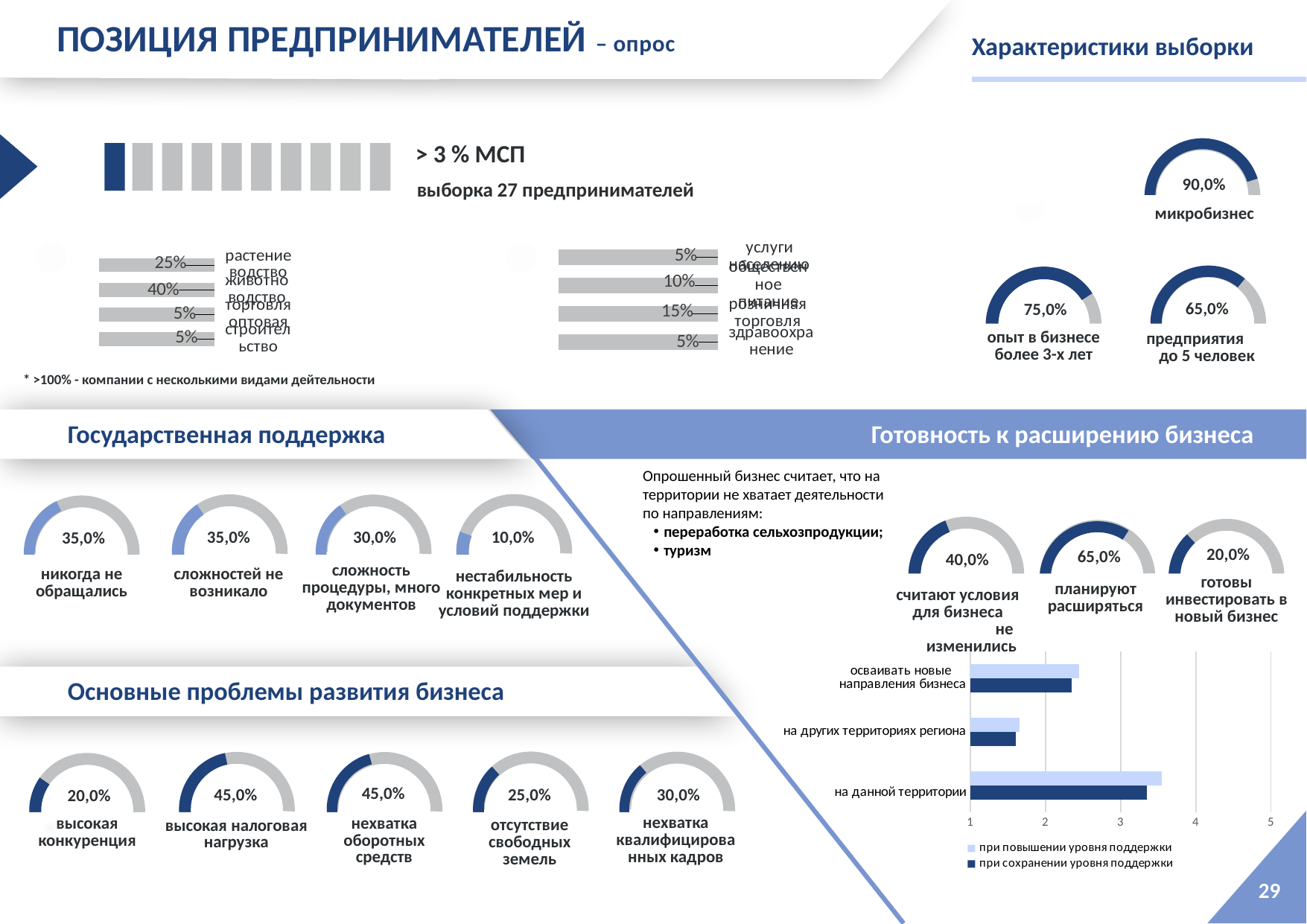
In the 'Государственная поддержка' section, what is the value shown for 'нестабильность конкретных мер и условий поддержки'? 10,0% In the 'Характеристики выборки' section, which is larger: 'микробизнес' or 'предприятия до 5 человек'? микробизнес In the bar chart at the bottom right, is the value for 'на данной территории' in the series 'при повышении уровня поддержки' greater or less than 3? greater In the 'Основные проблемы развития бизнеса' section, which problem has the lowest value? высокая конкуренция In the bar chart at the bottom right, which category has the lowest values? на других территориях региона In the bar chart at the bottom right with the legend 'при повышении уровня поддержки' / 'при сохранении уровня поддержки', how many series does the legend list? 2 What kind of chart is the chart at the bottom right with categories 'на данной территории', 'на других территориях региона' and 'осваивать новые направления бизнеса'? bar chart In the 'Готовность к расширению бизнеса' section, what is the difference between 'планируют расширяться' and 'готовы инвестировать в новый бизнес'? 45,0% In the bar chart at the bottom right (legend 'при повышении уровня поддержки'), how many categories are shown on the vertical axis? 3 In the bar chart at the bottom right, is the value for 'на других территориях региона' in the series 'при сохранении уровня поддержки' greater or less than 2? less In the bar chart at the bottom right, which category has the highest values? на данной территории In the 'Основные проблемы развития бизнеса' section, what is the value shown for 'высокая налоговая нагрузка'? 45,0%